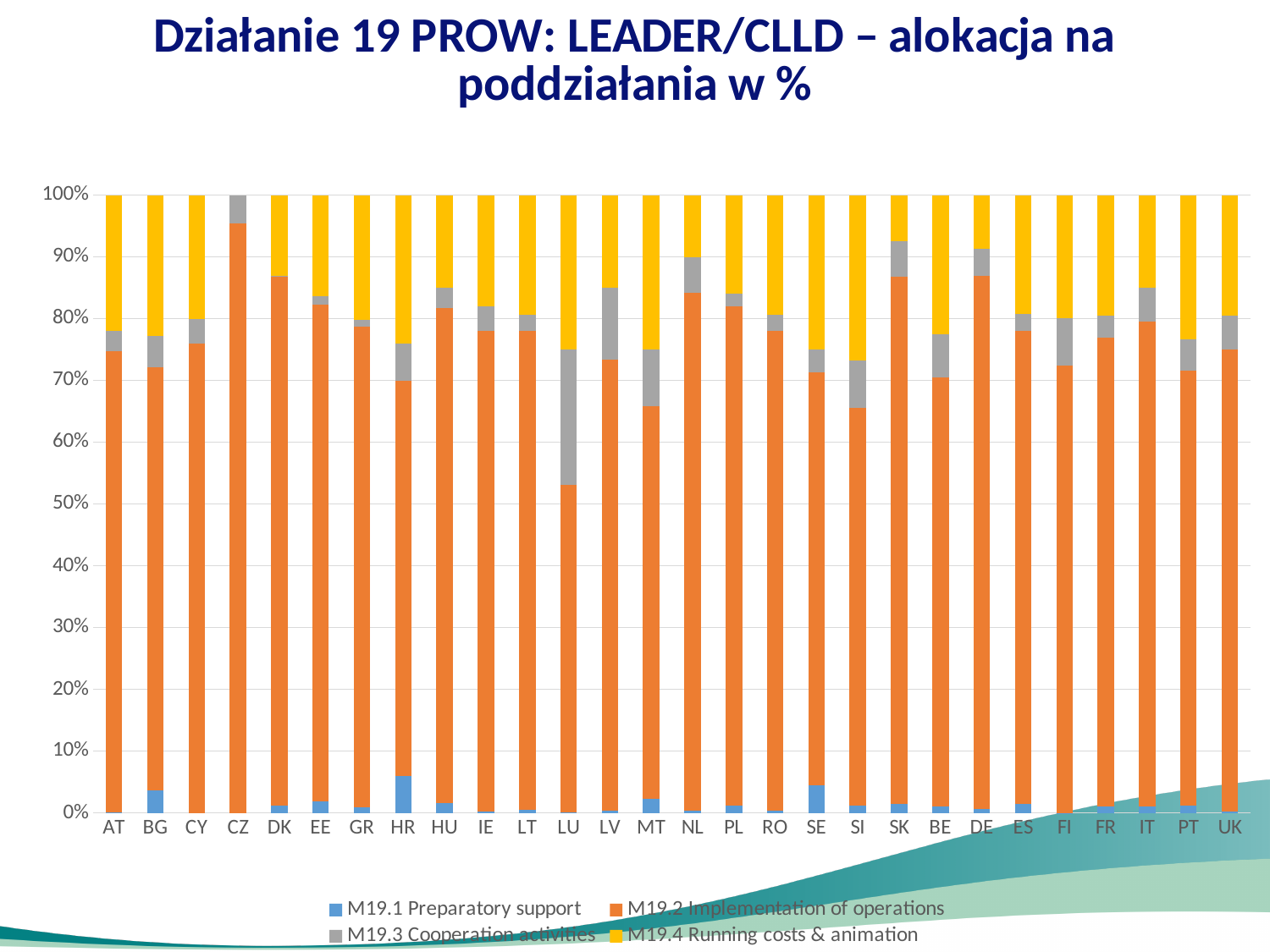
Is the M19.2 Implementation of operations share for LU greater or less than 60%? less Which country has the smallest share for M19.4 Running costs & animation? CZ Which country has the largest share for M19.2 Implementation of operations? CZ How many series does the chart legend list? 4 Which country has the smallest share for M19.2 Implementation of operations? LU Which country has the largest share for M19.3 Cooperation activities? LU Which legend entry is shown in yellow? M19.4 Running costs & animation Is the M19.2 Implementation of operations share for CZ greater or less than 90%? greater Which country has the largest share for M19.1 Preparatory support? HR What kind of chart is shown on the slide? Stacked bar chart How many countries are shown on the x axis of the chart? 28 Which has a larger M19.2 Implementation of operations share, SK or MT? SK